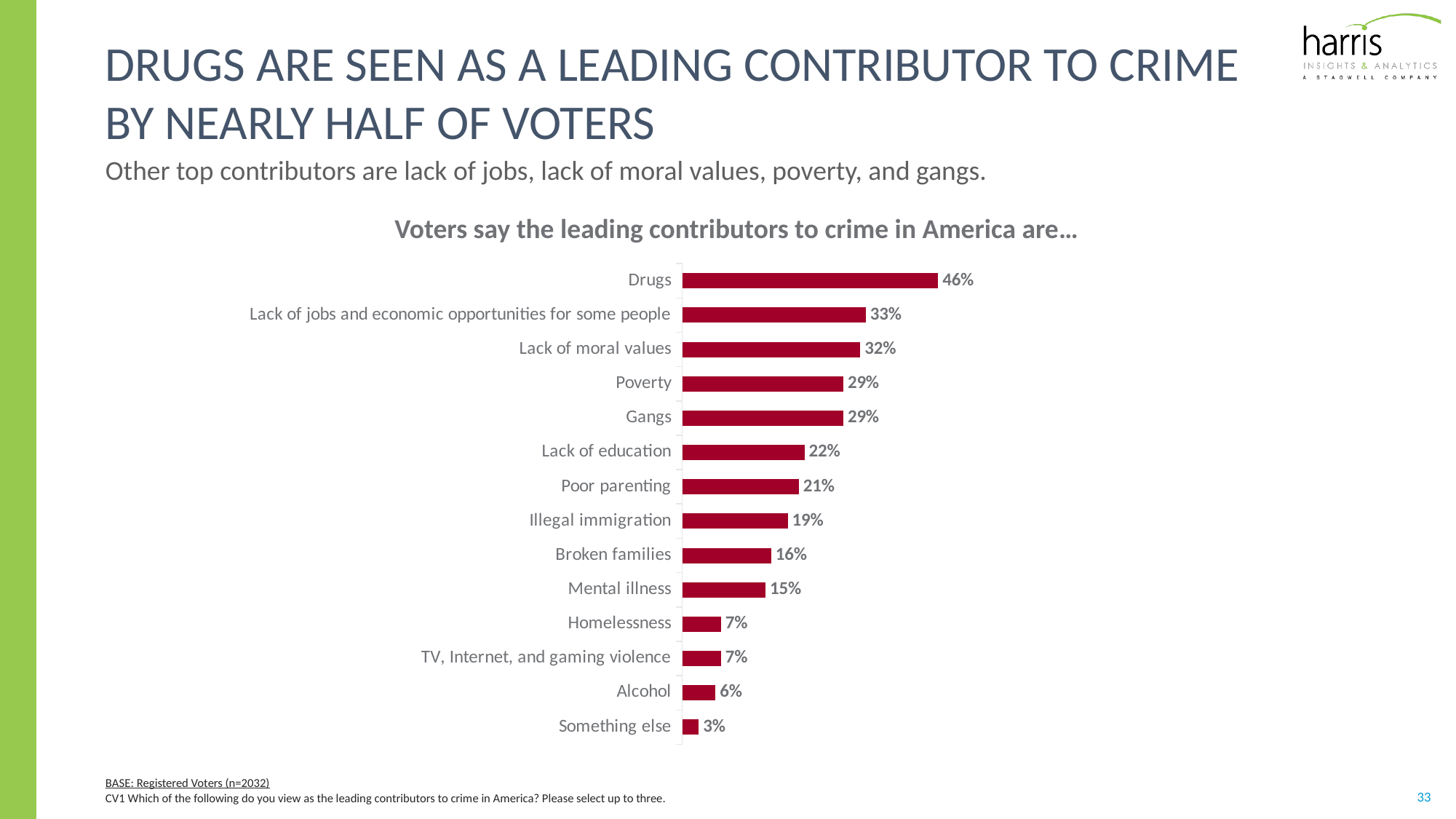
What is the value for Illegal immigration? 19% What is the difference between the values for Lack of education and Mental illness? 7% Which category has the highest value? Drugs What percentage of voters say drugs are a leading contributor to crime? 46% Which is larger, the value for Poor parenting or the value for Broken families? Poor parenting How many categories are shown in the chart? 14 What is the value for Lack of moral values? 32% What is the difference between the values for Drugs and Lack of jobs and economic opportunities for some people? 13% What is the value for Alcohol? 6% What is the title of the chart? Voters say the leading contributors to crime in America are… Which category has the lowest value? Something else What kind of chart is shown on the slide? Bar chart